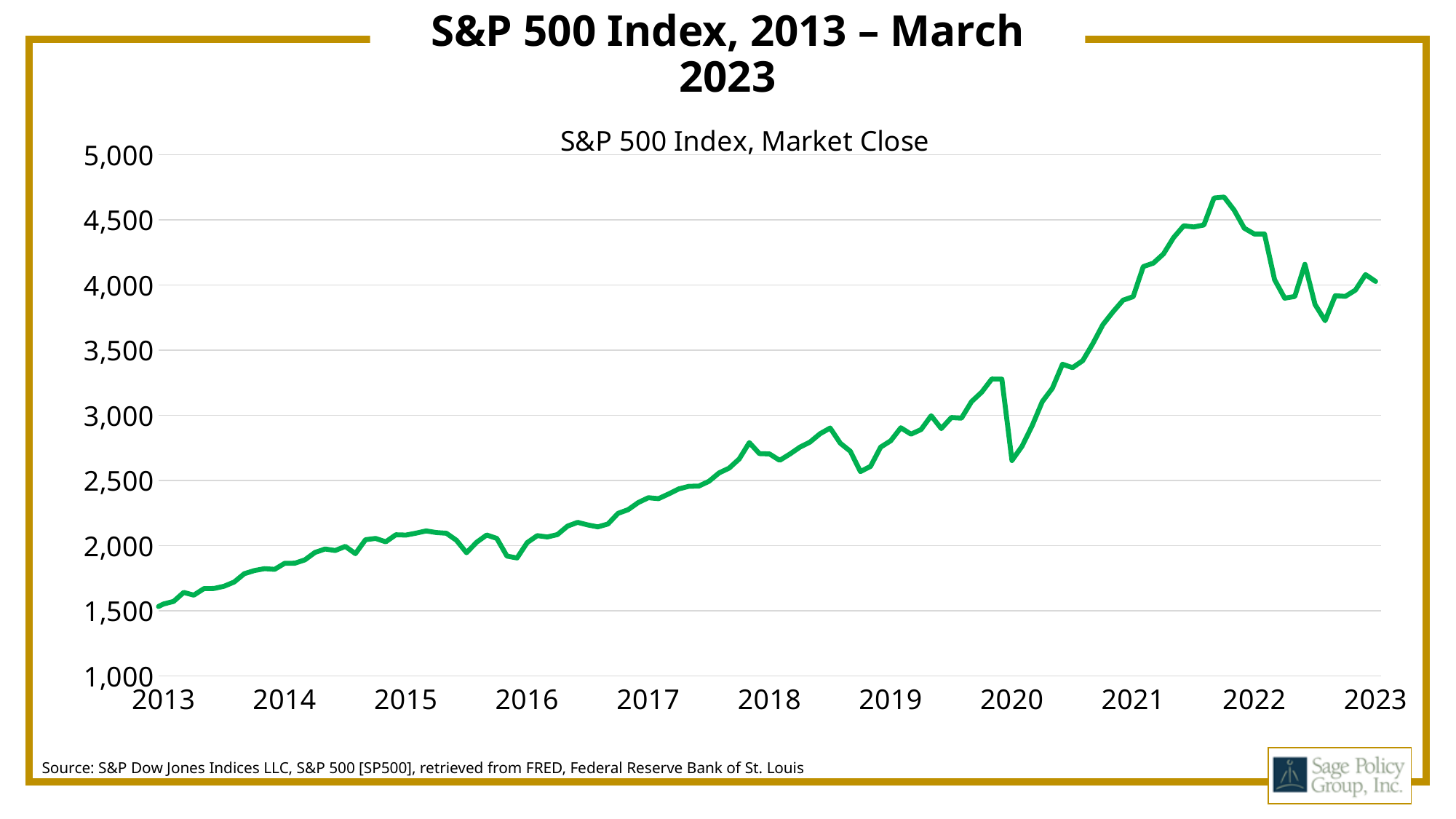
How many year labels are shown on the x axis? 11 Is the highest point on the line greater or less than 4,500? greater What kind of chart is shown on the slide? Line chart Is the value at the start of 2013 greater or less than 2,000? less What is the subtitle shown above the plot area? S&P 500 Index, Market Close How many data series are plotted on the chart? 1 In which year does the line reach its lowest value? 2013 Is the value at the start of 2018 greater or less than 2,500? greater What is the title of the chart on the slide? S&P 500 Index, 2013 – March 2023 Which is larger, the value at the start of 2016 or the value at the start of 2020? 2020 Overall, does the S&P 500 line rise or fall from 2013 to 2023? Rise